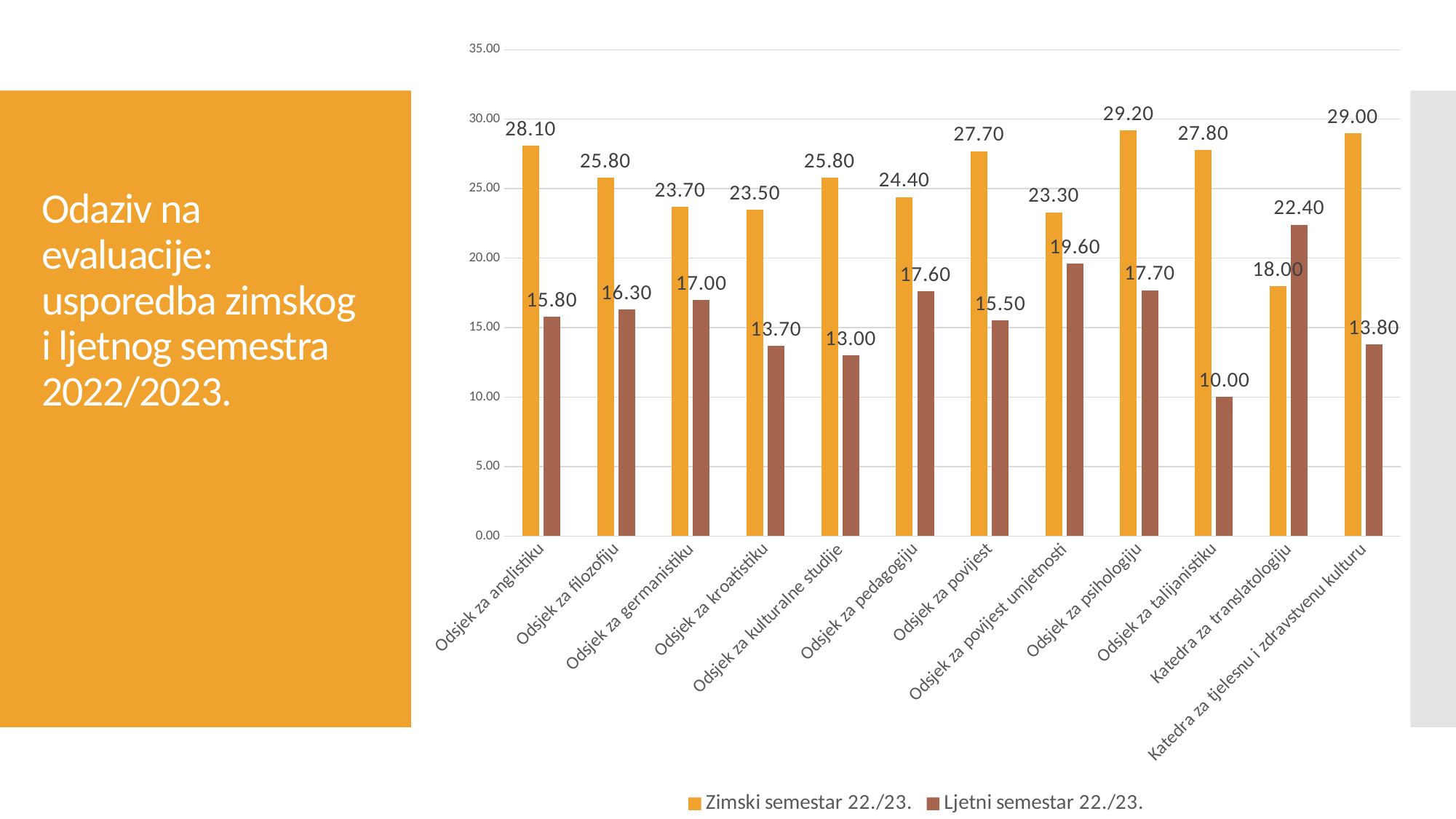
Which category has the lowest value in the Zimski semestar 22./23. series? Katedra za translatologiju For Katedra za translatologiju, which series has the larger value: Zimski semestar 22./23. or Ljetni semestar 22./23.? Ljetni semestar 22./23. How many categories are shown on the x axis? 12 What is the value for Katedra za translatologiju in the Ljetni semestar 22./23. series? 22.40 How many series does the legend list? 2 What kind of chart is shown on the slide? Bar chart What is the value for Odsjek za talijanistiku in the Ljetni semestar 22./23. series? 10.00 What is the difference between the Zimski semestar 22./23. and Ljetni semestar 22./23. values for Odsjek za anglistiku? 12.30 Which category has the lowest value in the Ljetni semestar 22./23. series? Odsjek za talijanistiku What is the value for Odsjek za anglistiku in the Zimski semestar 22./23. series? 28.10 Which category has the highest value in the Ljetni semestar 22./23. series? Katedra za translatologiju Which category has the highest value in the Zimski semestar 22./23. series? Odsjek za psihologiju